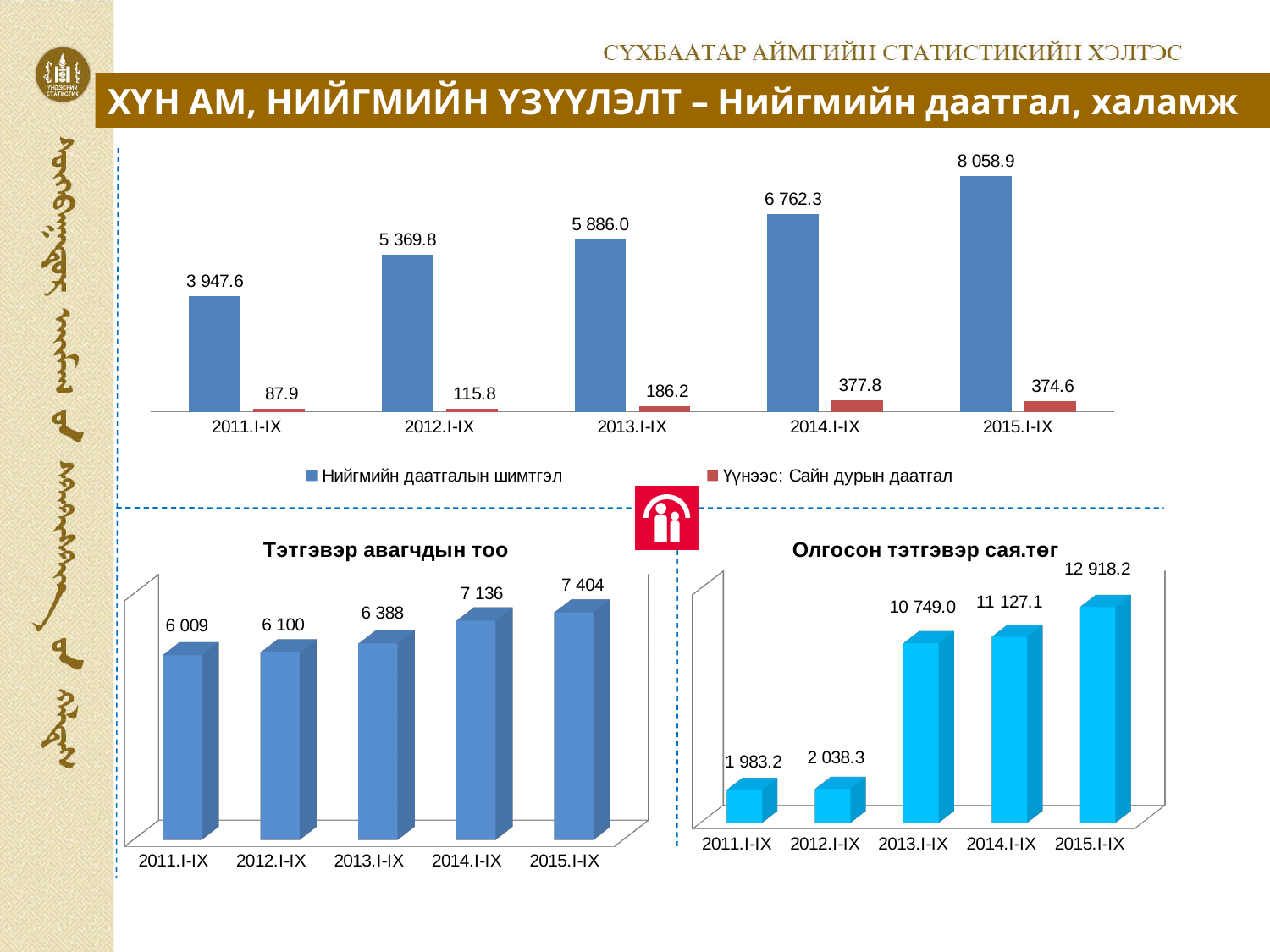
In the top chart, does Нийгмийн даатгалын шимтгэл rise or fall from 2011.I-IX to 2015.I-IX? rise In the top chart, what is the value of Нийгмийн даатгалын шимтгэл for 2015.I-IX? 8 058.9 In the chart titled Тэтгэвэр авагчдын тоо, which period has the lowest value? 2011.I-IX In the chart titled Олгосон тэтгэвэр сая.төг, which is larger, the value for 2012.I-IX or 2013.I-IX? 2013.I-IX In the top chart, what is the value of Үүнээс: Сайн дурын даатгал for 2013.I-IX? 186.2 In the top chart, which period has the highest value of Үүнээс: Сайн дурын даатгал? 2014.I-IX In the top chart, how many series does the legend list? 2 In the chart titled Тэтгэвэр авагчдын тоо, what is the value for 2013.I-IX? 6 388 In the chart titled Олгосон тэтгэвэр сая.төг, which period has the highest value? 2015.I-IX In the chart titled Олгосон тэтгэвэр сая.төг, what is the value for 2014.I-IX? 11 127.1 In the chart titled Тэтгэвэр авагчдын тоо, what is the difference between the values for 2015.I-IX and 2014.I-IX? 268 What kind of chart is the chart titled Олгосон тэтгэвэр сая.төг? bar chart